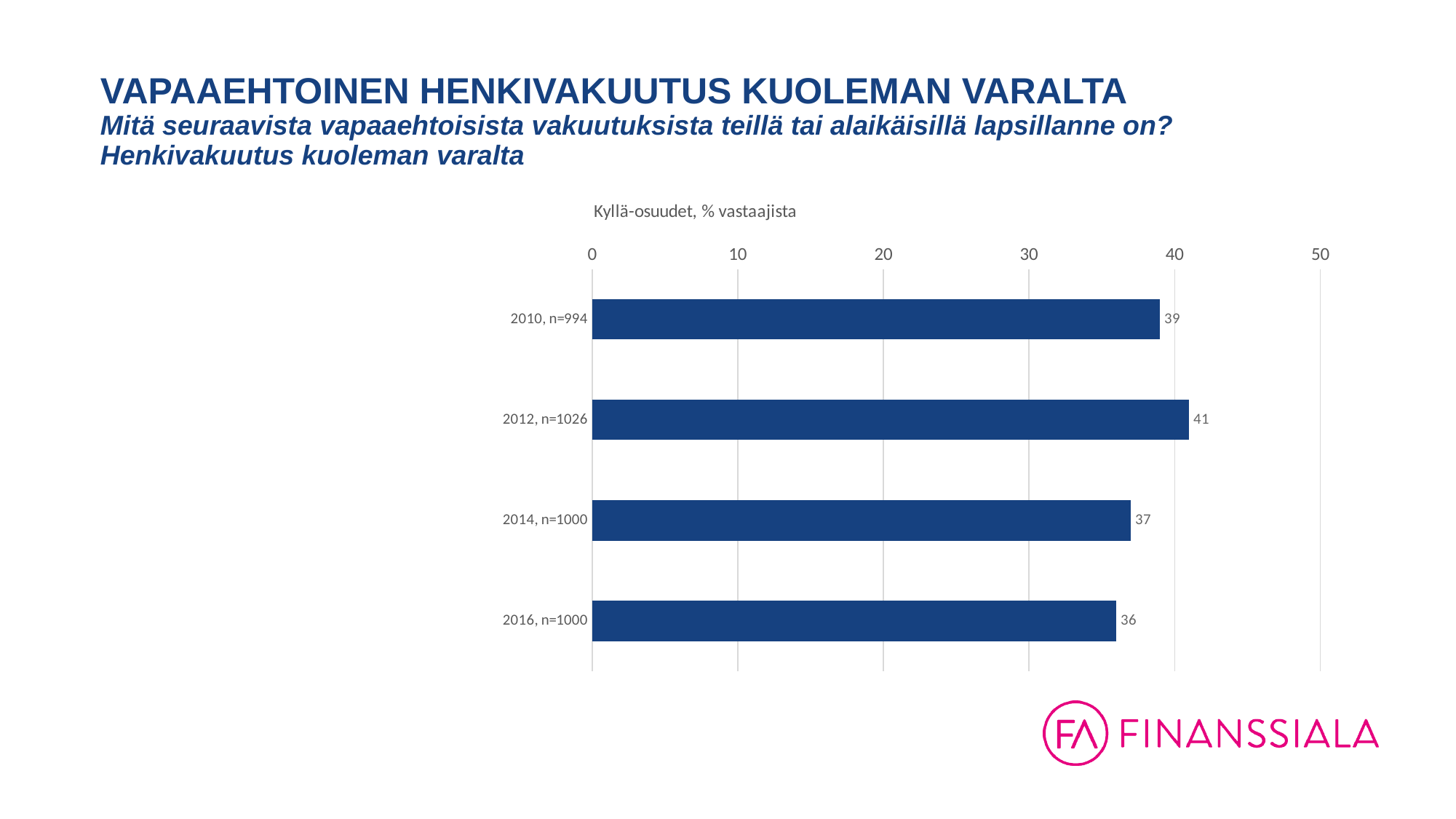
What is the value for 2010, n=994? 39 Which is larger, the value for 2010, n=994 or the value for 2014, n=1000? 2010, n=994 What is the difference between the values for 2012, n=1026 and 2016, n=1000? 5 How many categories are shown in the chart? 4 What is the value for 2016, n=1000? 36 Which category has the highest value? 2012, n=1026 Is the value for 2012, n=1026 greater or less than 40? greater What kind of chart is shown on the slide? Bar chart What is the value for 2014, n=1000? 37 Which category has the lowest value? 2016, n=1000 What is the value for 2012, n=1026? 41 What is the chart's title? Kyllä-osuudet, % vastaajista